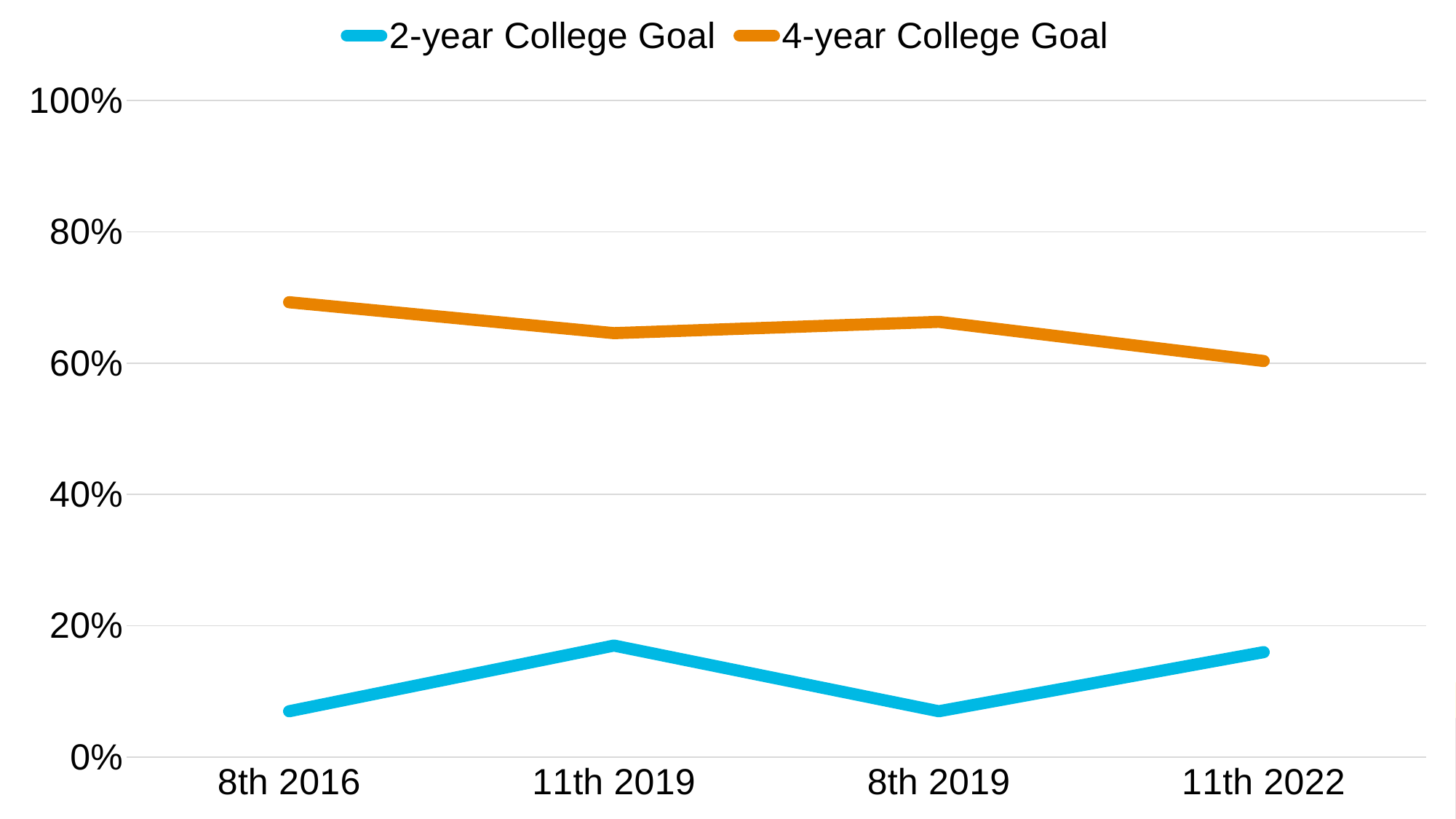
At which x-axis point is the 4-year College Goal value highest? 8th 2016 Is the 2-year College Goal value at 11th 2019 greater or less than 20%? less At which x-axis point is the 4-year College Goal value lowest? 11th 2022 What kind of chart is shown on the slide? line chart Which series is shown in blue? 2-year College Goal How many points are plotted along the x axis for each series? 4 How many series does the legend list? 2 At 8th 2019, which series has the larger value, 2-year College Goal or 4-year College Goal? 4-year College Goal Which series is shown in orange? 4-year College Goal Is the 4-year College Goal value at 8th 2019 greater or less than 80%? less Does the 4-year College Goal line rise or fall from 8th 2016 to 11th 2022? fall Is the 4-year College Goal value at 8th 2016 greater or less than 60%? greater